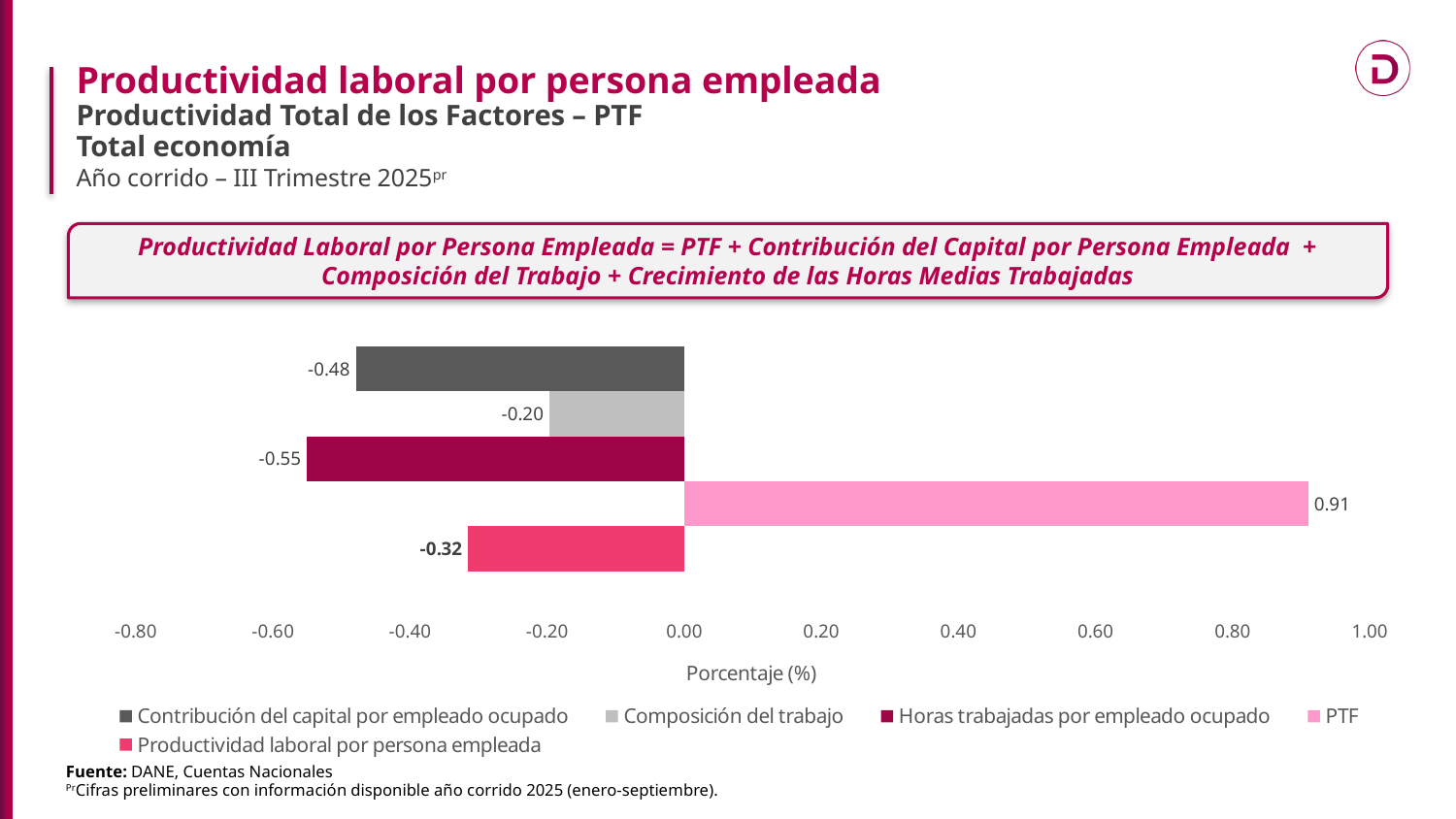
Which series has the highest value? PTF How many series does the legend list? 5 What is the value for Contribución del capital por empleado ocupado? -0.48 Which is larger, the value for Composición del trabajo or the value for Contribución del capital por empleado ocupado? Composición del trabajo What is the value for Horas trabajadas por empleado ocupado? -0.55 Which series has the lowest value? Horas trabajadas por empleado ocupado What kind of chart is shown on the slide? Bar chart What is the value for Productividad laboral por persona empleada? -0.32 What is the value for Composición del trabajo? -0.20 What is the value for PTF? 0.91 What is the difference between the value for PTF and the value for Productividad laboral por persona empleada? 1.23 Is the value for PTF greater or less than 0.80? greater